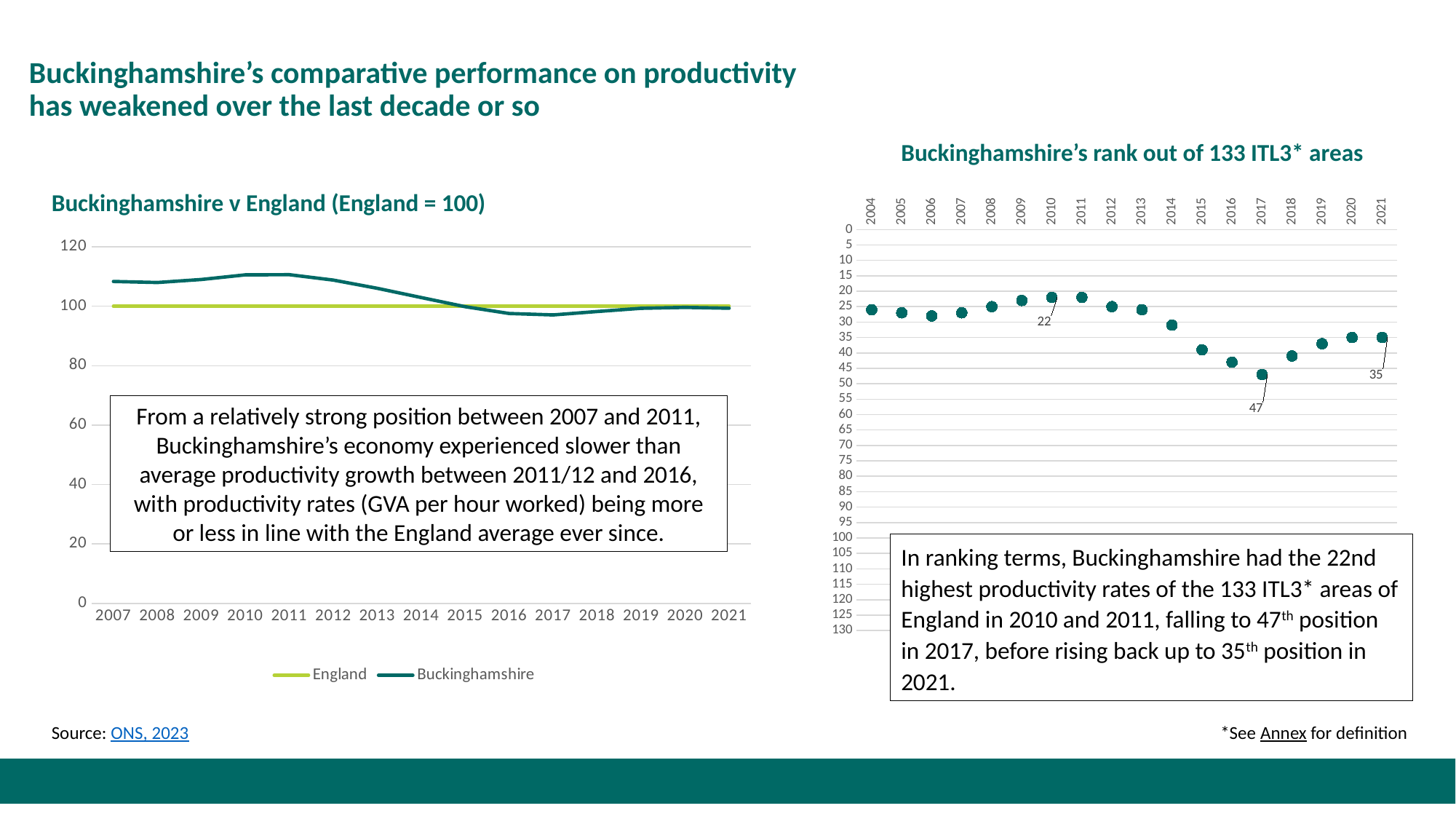
What kind of chart is the 'Buckinghamshire v England (England = 100)' chart on the left? Line chart In the 'Buckinghamshire v England (England = 100)' chart, is the Buckinghamshire value for 2017 greater or less than 100? less In the 'Buckinghamshire's rank out of 133 ITL3* areas' chart, what was Buckinghamshire's rank in 2021? 35 In the 'Buckinghamshire's rank out of 133 ITL3* areas' chart, what was Buckinghamshire's rank in 2017? 47 In the 'Buckinghamshire's rank out of 133 ITL3* areas' chart, what is the difference between the 2017 rank and the 2010 rank? 25 In the 'Buckinghamshire v England (England = 100)' chart, what constant value does the England line sit at? 100 In the 'Buckinghamshire v England (England = 100)' chart, does the Buckinghamshire line rise or fall between 2011 and 2016? Fall In the 'Buckinghamshire's rank out of 133 ITL3* areas' chart, what was Buckinghamshire's rank in 2010? 22 How many series does the legend of the 'Buckinghamshire v England (England = 100)' chart list? 2 How many years are shown on the x axis of the 'Buckinghamshire v England (England = 100)' chart? 15 In the 'Buckinghamshire's rank out of 133 ITL3* areas' chart, which year has the highest rank number (the lowest point on the chart)? 2017 In the 'Buckinghamshire v England (England = 100)' chart, is the Buckinghamshire value for 2010 greater or less than 100? greater